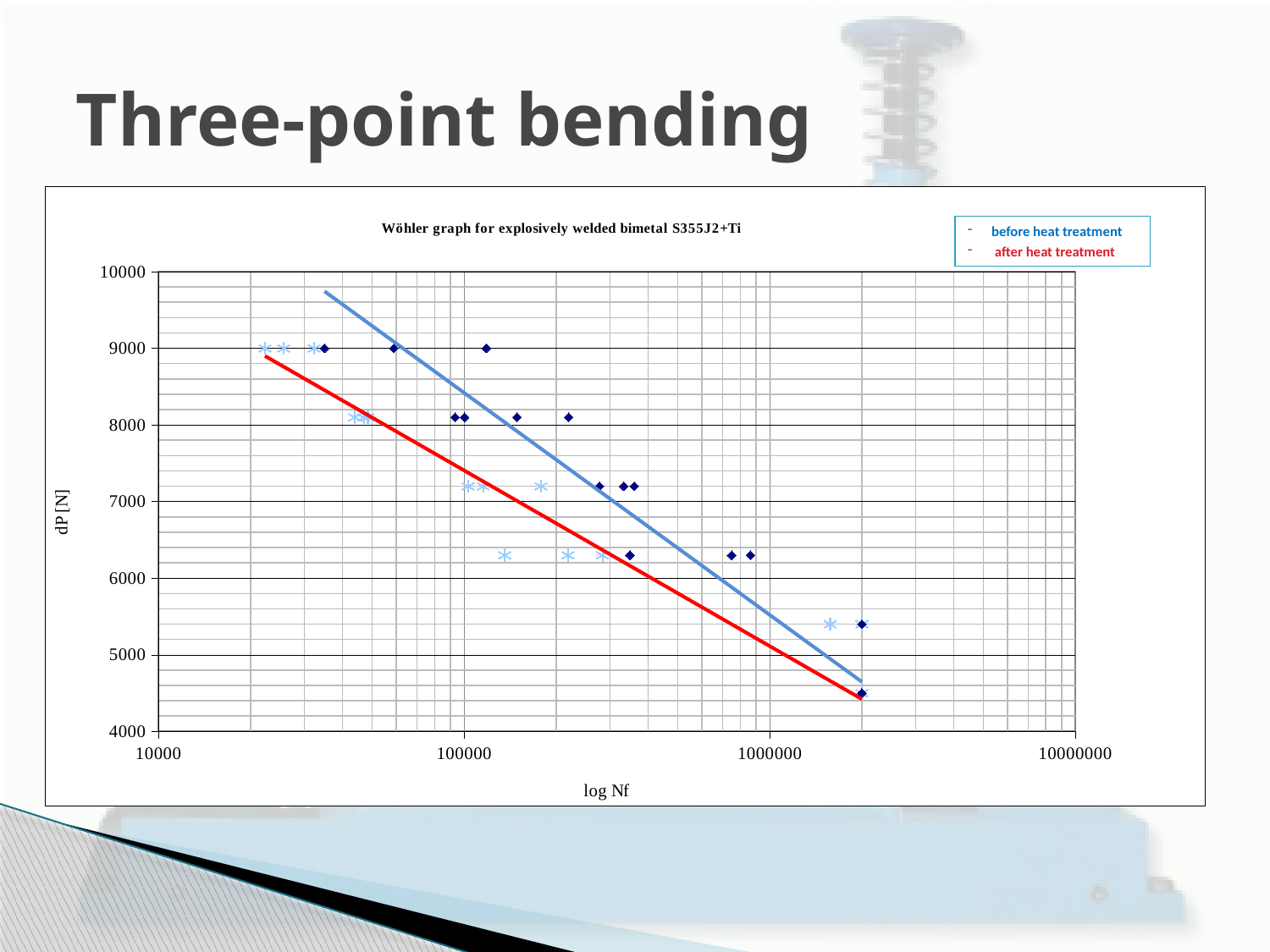
Which trend line lies higher on the chart, before heat treatment or after heat treatment? before heat treatment How many series does the legend list? 2 Which series is drawn with the red line? after heat treatment What is the title of the chart? Wöhler graph for explosively welded bimetal S355J2+Ti Do the dP values rise or fall as log Nf increases? fall What is the highest dP value at which data points are plotted? 9000 What kind of chart is shown on the slide? scatter chart Are the data points plotted just below log Nf = 1000000 greater or less than 6000 in dP? greater Is the dP value of the lowest plotted points greater or less than 5000? less